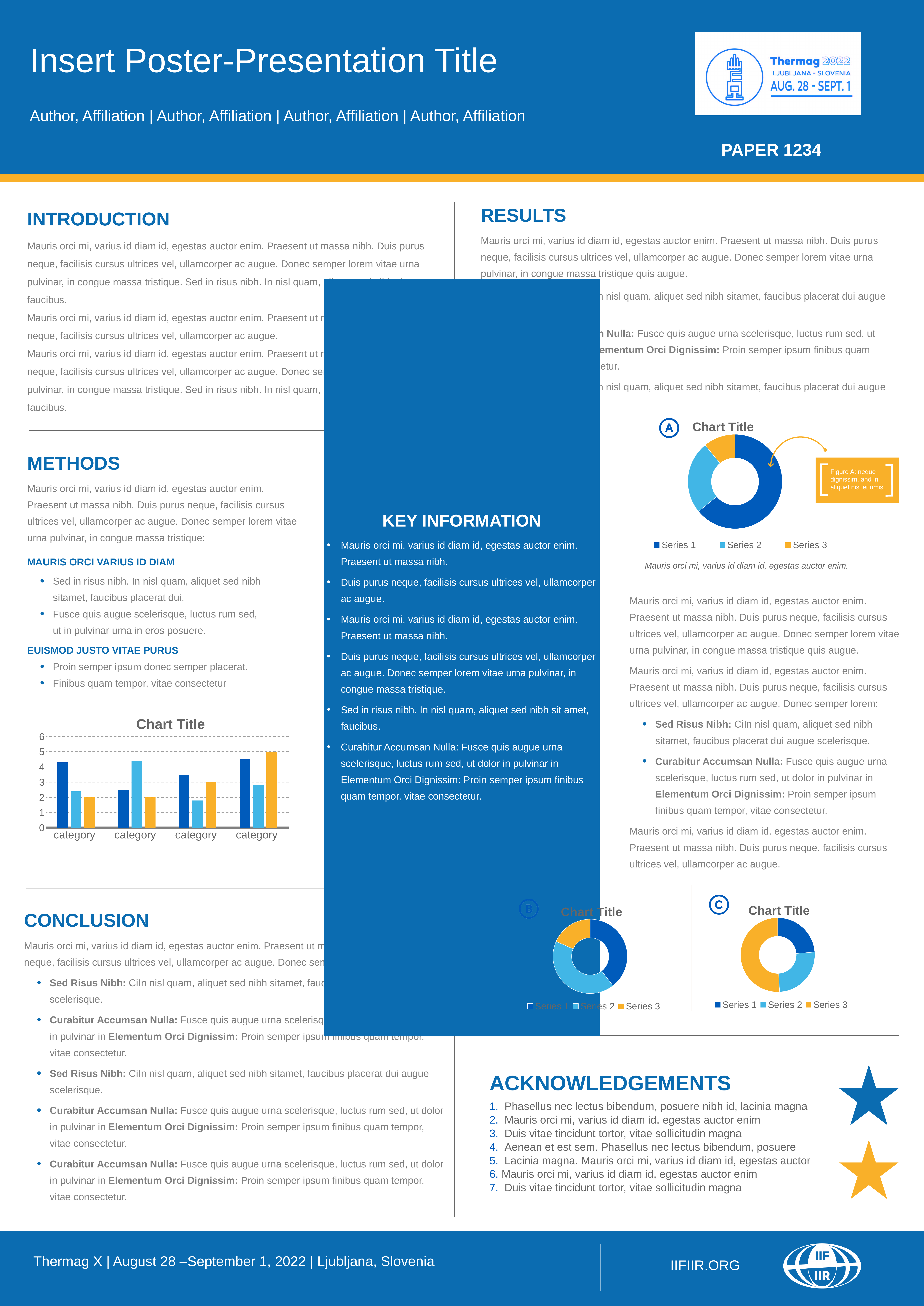
In the bar chart in the METHODS section, is the orange bar in the fourth category group greater or less than 4? greater In the bar chart in the METHODS section, is the dark blue bar in the first category group greater or less than 4? greater What is the highest value shown on the y axis of the bar chart in the METHODS section? 6 How many category groups does the bar chart in the METHODS section show on its x axis? 4 What kind of chart is chart A in the RESULTS section? doughnut chart In chart A in the RESULTS section, which series has the smallest slice? Series 3 What kind of chart is the chart in the METHODS section (bottom left)? bar chart In chart A in the RESULTS section, which series has the largest slice? Series 1 In the bar chart in the METHODS section, is the light blue bar in the third category group greater or less than 3? less How many series does the legend of chart A in the RESULTS section list? 3 In the bar chart in the METHODS section, which bar is taller in the second category group: the dark blue bar or the light blue bar? the light blue bar In chart C in the RESULTS section, which series has the largest slice? Series 3